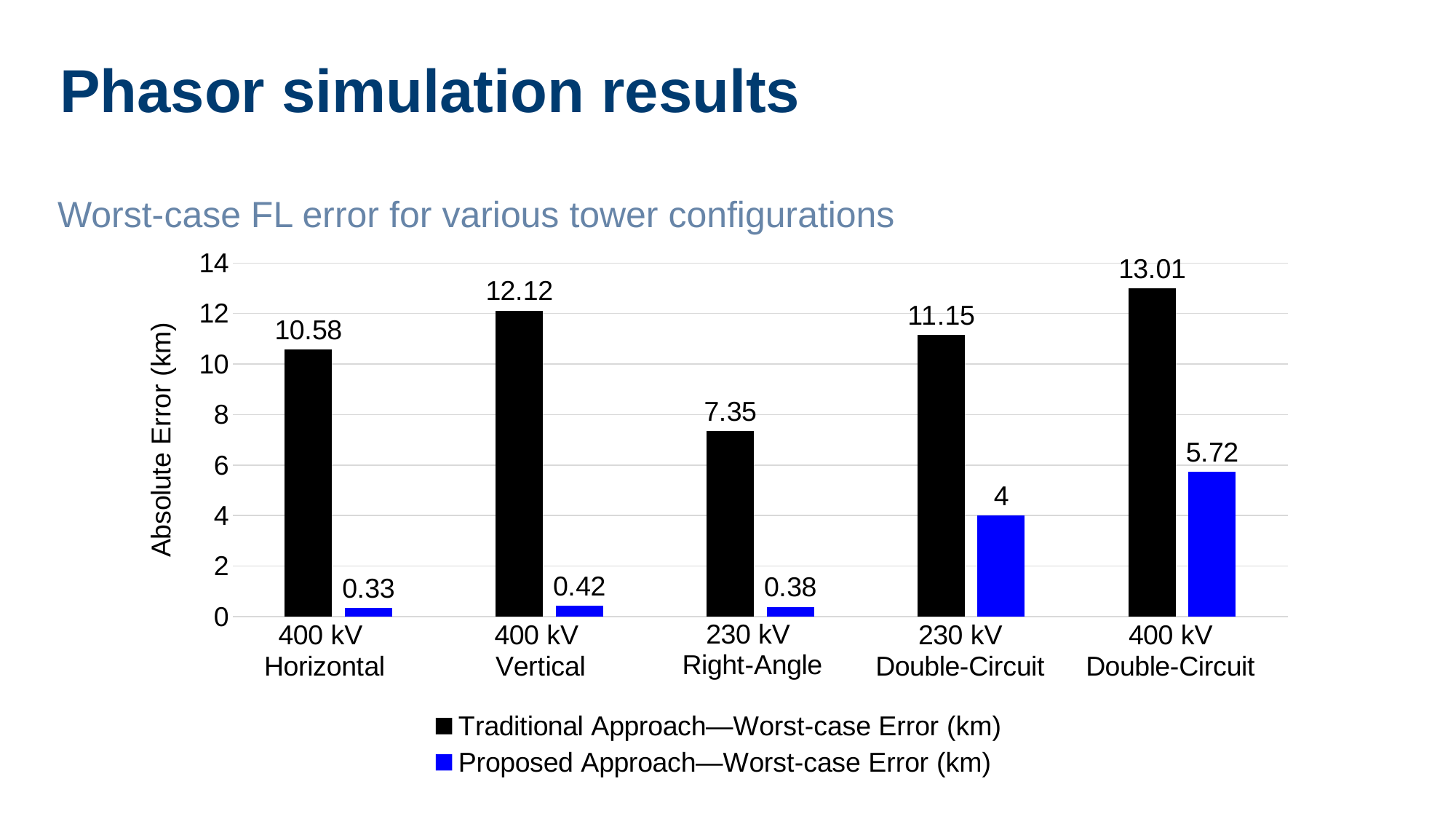
What is the Traditional Approach worst-case error for 400 kV Horizontal? 10.58 What kind of chart is shown on the slide? bar chart How many series does the legend list? 2 What is the label of the y axis? Absolute Error (km) Which tower configuration has the highest Traditional Approach worst-case error? 400 kV Double-Circuit What is the Proposed Approach worst-case error for 400 kV Vertical? 0.42 Is the Traditional Approach error for 230 kV Right-Angle greater or less than 8? less Which is larger, the Traditional Approach error for 400 kV Vertical or for 230 kV Double-Circuit? 400 kV Vertical What is the difference between the Traditional and Proposed Approach worst-case errors for 400 kV Double-Circuit? 7.29 Which tower configuration has the lowest Proposed Approach worst-case error? 400 kV Horizontal What is the Proposed Approach worst-case error for 230 kV Double-Circuit? 4 How many tower configurations are shown on the x axis? 5